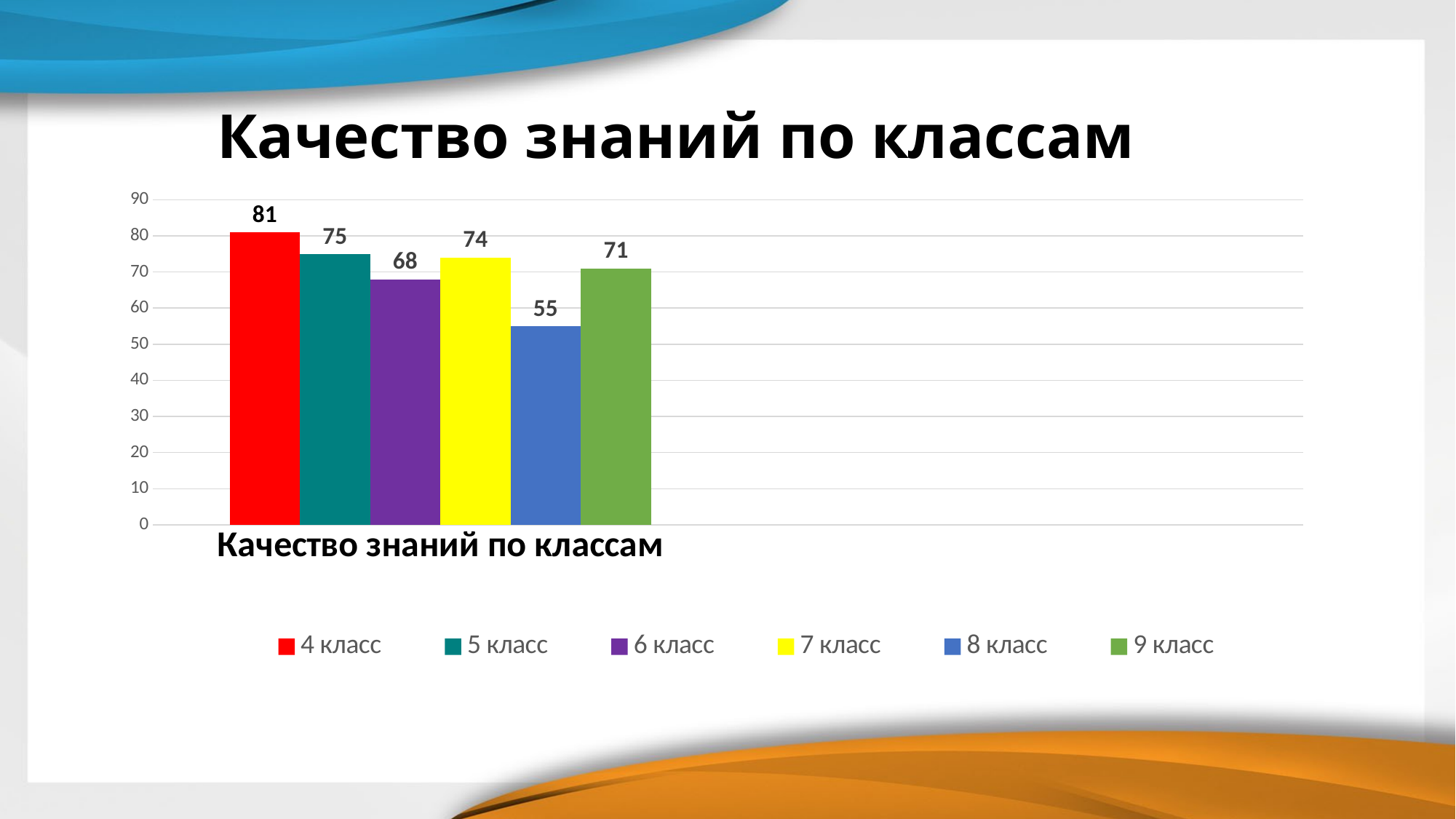
What is the difference between the values for 4 класс and 8 класс? 26 Which is larger, the value for 7 класс or the value for 9 класс? 7 класс Which class has the highest value? 4 класс What is the value for 9 класс? 71 What kind of chart is shown on the slide? bar chart What is the value for 8 класс? 55 What is the difference between the values for 5 класс and 6 класс? 7 What colour is the bar for 7 класс? yellow Which class has the lowest value? 8 класс What is the value for 4 класс? 81 How many series does the legend list? 6 Is the value for 6 класс greater or less than 60? greater